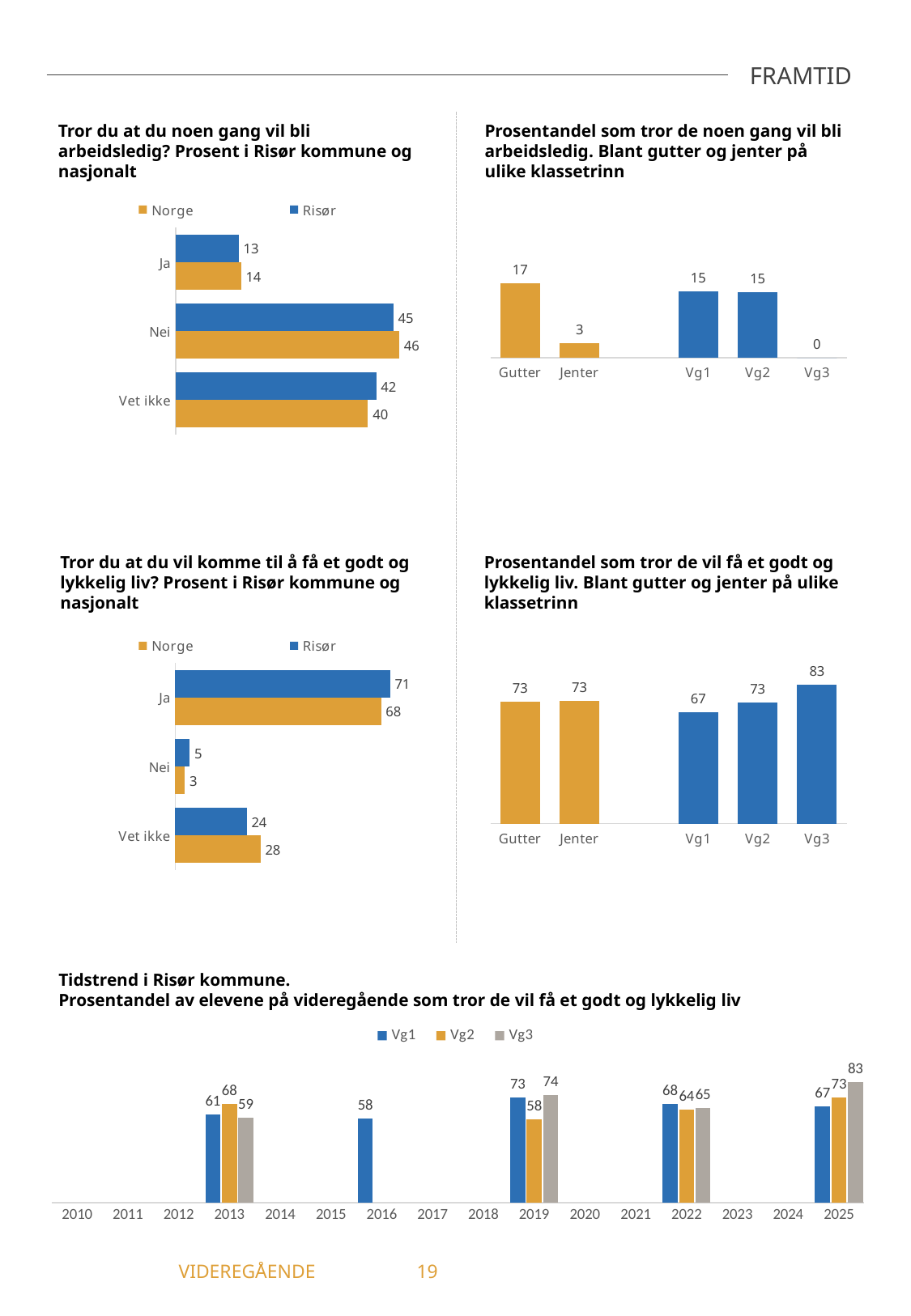
In the chart 'Tror du at du noen gang vil bli arbeidsledig? Prosent i Risør kommune og nasjonalt', how many series does the legend list? 2 What kind of chart is 'Tror du at du vil komme til å få et godt og lykkelig liv? Prosent i Risør kommune og nasjonalt'? Bar chart In the chart 'Tror du at du noen gang vil bli arbeidsledig? Prosent i Risør kommune og nasjonalt', what is the value for Risør for 'Nei'? 45 In the chart 'Tidstrend i Risør kommune', what is the value for Vg3 in 2025? 83 In the chart 'Tror du at du noen gang vil bli arbeidsledig? Prosent i Risør kommune og nasjonalt', what is the difference between the Norge and Risør values for 'Vet ikke'? 2 In the chart 'Prosentandel som tror de noen gang vil bli arbeidsledig. Blant gutter og jenter på ulike klassetrinn', what is the value for Vg3? 0 In the chart 'Tror du at du vil komme til å få et godt og lykkelig liv? Prosent i Risør kommune og nasjonalt', which is larger for 'Ja': Norge or Risør? Risør In the chart 'Prosentandel som tror de vil få et godt og lykkelig liv. Blant gutter og jenter på ulike klassetrinn', which category has the lowest value? Vg1 In the chart 'Tror du at du vil komme til å få et godt og lykkelig liv? Prosent i Risør kommune og nasjonalt', what is the Norge value for 'Vet ikke'? 28 In the chart 'Prosentandel som tror de noen gang vil bli arbeidsledig. Blant gutter og jenter på ulike klassetrinn', which category has the highest value? Gutter In the chart 'Prosentandel som tror de noen gang vil bli arbeidsledig. Blant gutter og jenter på ulike klassetrinn', how many categories are shown on the x axis? 5 In the chart 'Tidstrend i Risør kommune', what is the difference between the Vg1 and Vg2 values in 2019? 15